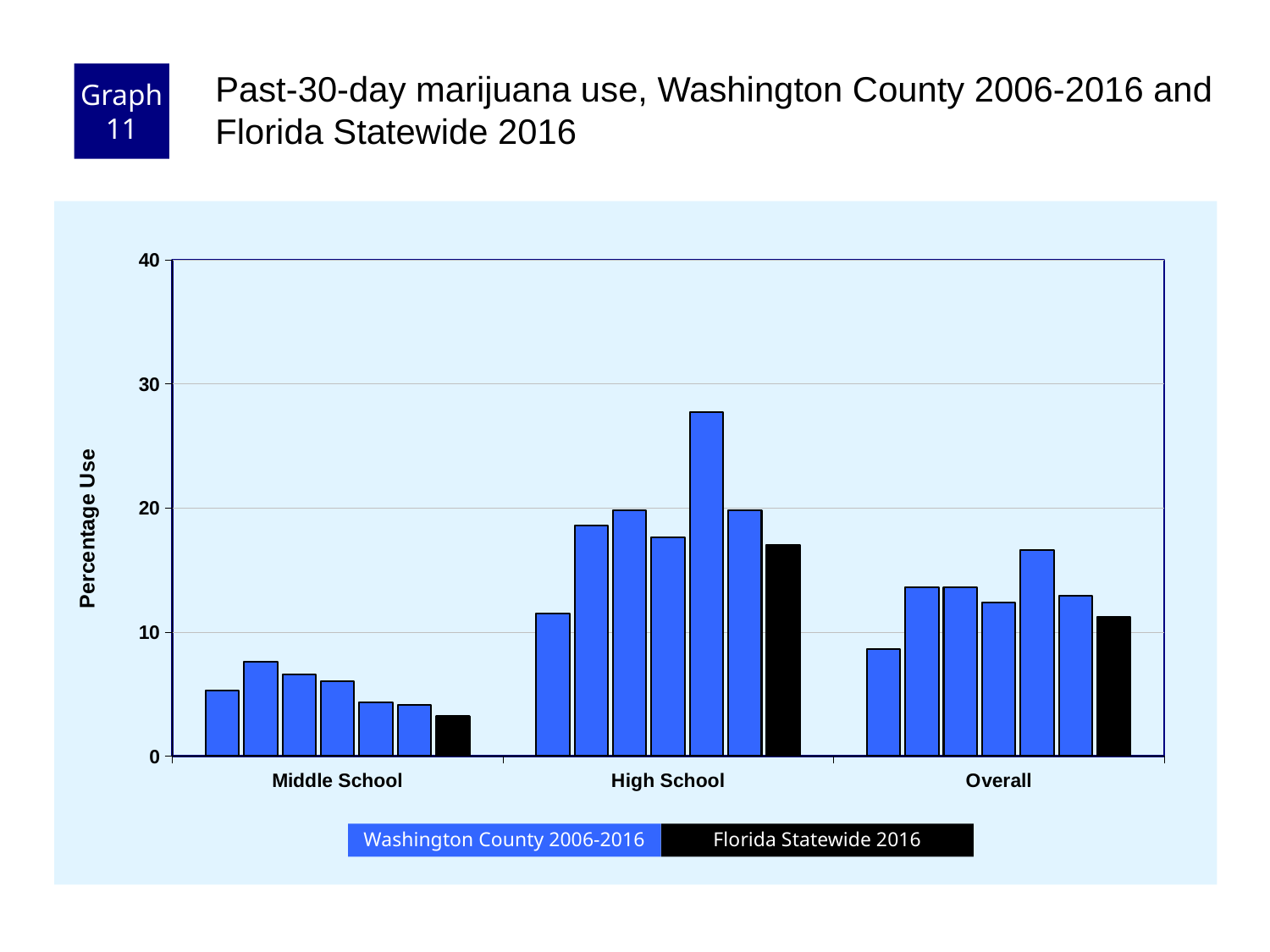
Which category has the lowest bars? Middle School How many categories are shown on the x axis? 3 Is the Florida Statewide 2016 value for Middle School greater or less than 10? less How many series does the legend list? 2 Is the tallest Washington County bar for Middle School greater or less than 10? less What colour are the Florida Statewide 2016 bars? black What is the label on the y axis? Percentage Use What kind of chart is shown on the slide? bar chart Is the Florida Statewide 2016 value for High School greater or less than 10? greater Which is larger, the Florida Statewide 2016 value for High School or for Overall? High School Which category has the highest bars? High School